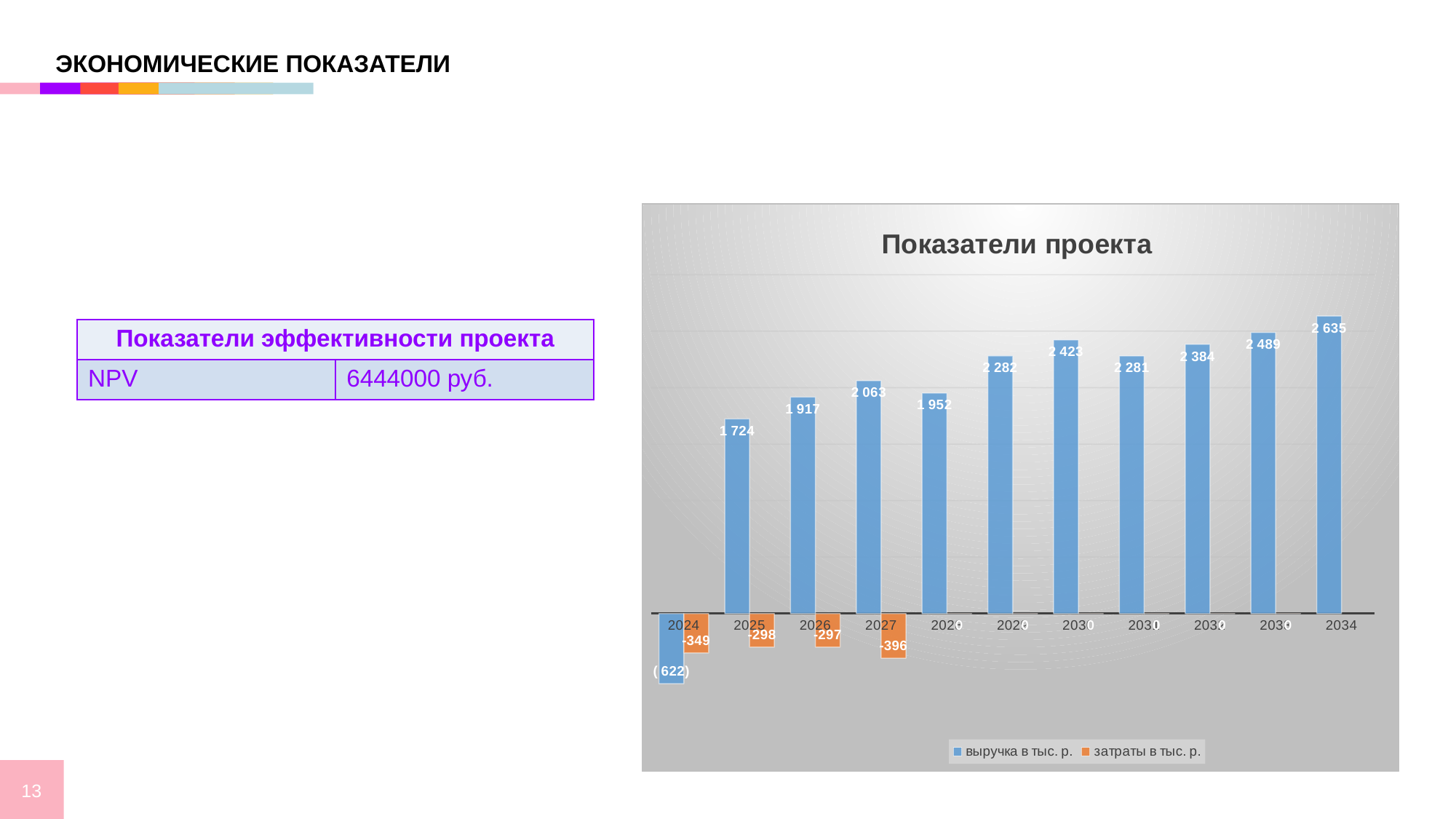
What is the value of выручка в тыс. р. for 2034? 2 635 Which year has the highest value of выручка в тыс. р.? 2034 What is the value of затраты в тыс. р. for 2027? -396 What is the value of затраты в тыс. р. for 2024? -349 Which is larger, выручка в тыс. р. in 2026 or in 2027? 2027 Which year has the lowest value of выручка в тыс. р.? 2024 What is the value of выручка в тыс. р. for 2025? 1 724 What is the difference between выручка в тыс. р. in 2027 and in 2025? 339 What kind of chart is "Показатели проекта"? bar chart What are the two series named in the legend of "Показатели проекта"? выручка в тыс. р. and затраты в тыс. р. How many years are shown on the x axis of "Показатели проекта"? 11 How many series does the legend of "Показатели проекта" list? 2